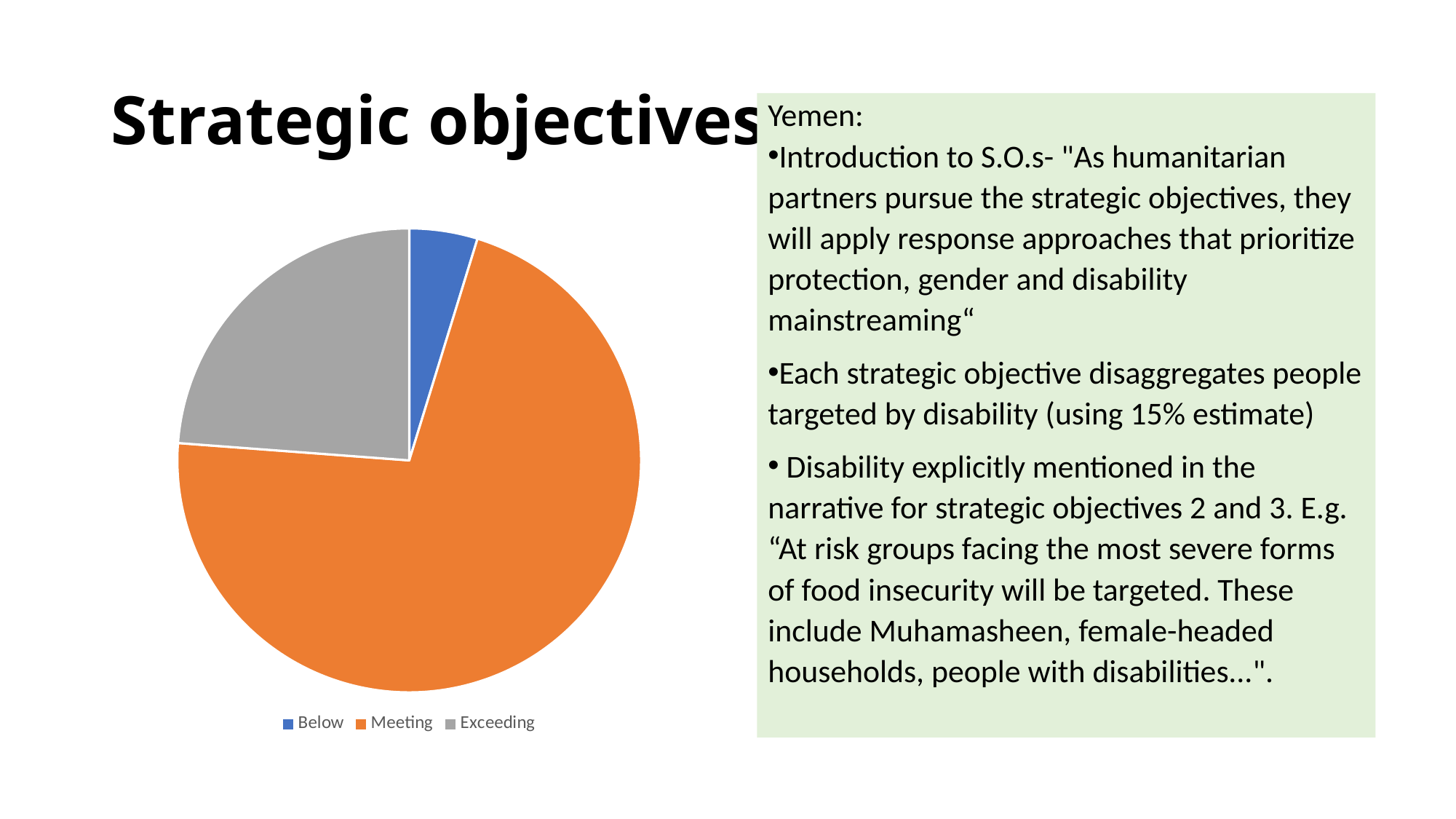
How many slices does the pie chart have? 3 What colour is the Exceeding slice in the pie chart? grey Which category is shown in orange in the pie chart? Meeting Which category has the largest slice of the pie chart? Meeting Which category has the smallest slice of the pie chart? Below How many entries does the pie chart's legend list? 3 Which slice is larger in the pie chart, Exceeding or Below? Exceeding What kind of chart is shown on the slide? pie chart Which slice is larger in the pie chart, Meeting or Exceeding? Meeting